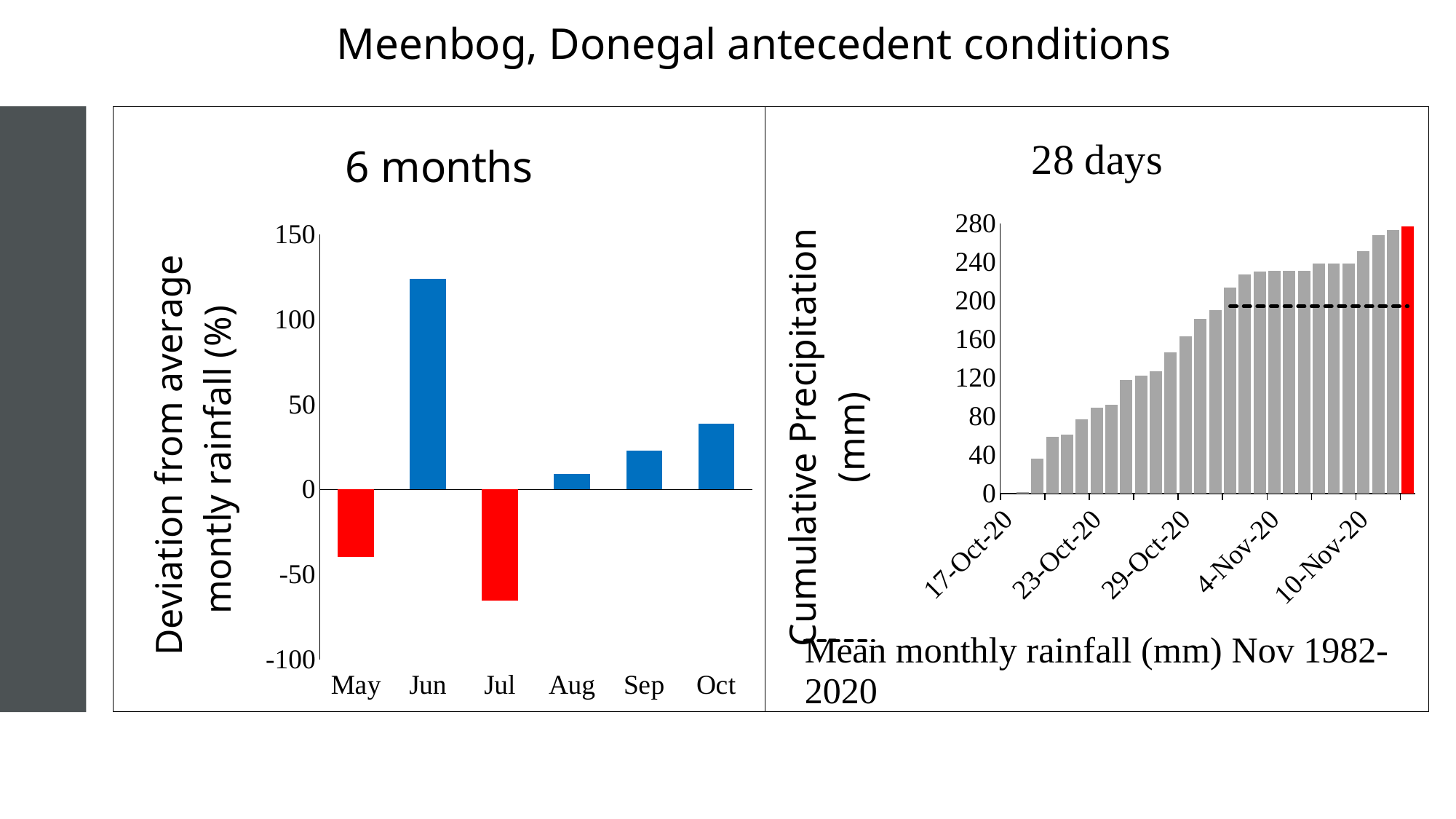
How many months are shown in the '6 months' chart? 6 In the '28 days' chart, is the value of the final (red) bar greater or less than 240? greater In the '6 months' chart, which is larger, the value for Aug or the value for Sep? Sep In the '28 days' chart, do the values rise or fall from 17-Oct-20 to the last date? rise In the '6 months' chart, which is larger, the value for Sep or the value for Oct? Oct In the '6 months' chart, which month has the lowest deviation from average monthly rainfall? Jul In the '6 months' chart, is the value for Oct greater or less than 50? less What kind of chart is the '6 months' chart? bar chart In the '6 months' chart, is the value for Jul greater or less than -50? less In the '6 months' chart, which month has the highest deviation from average monthly rainfall? Jun What is the y-axis label of the '28 days' chart? Cumulative Precipitation (mm)